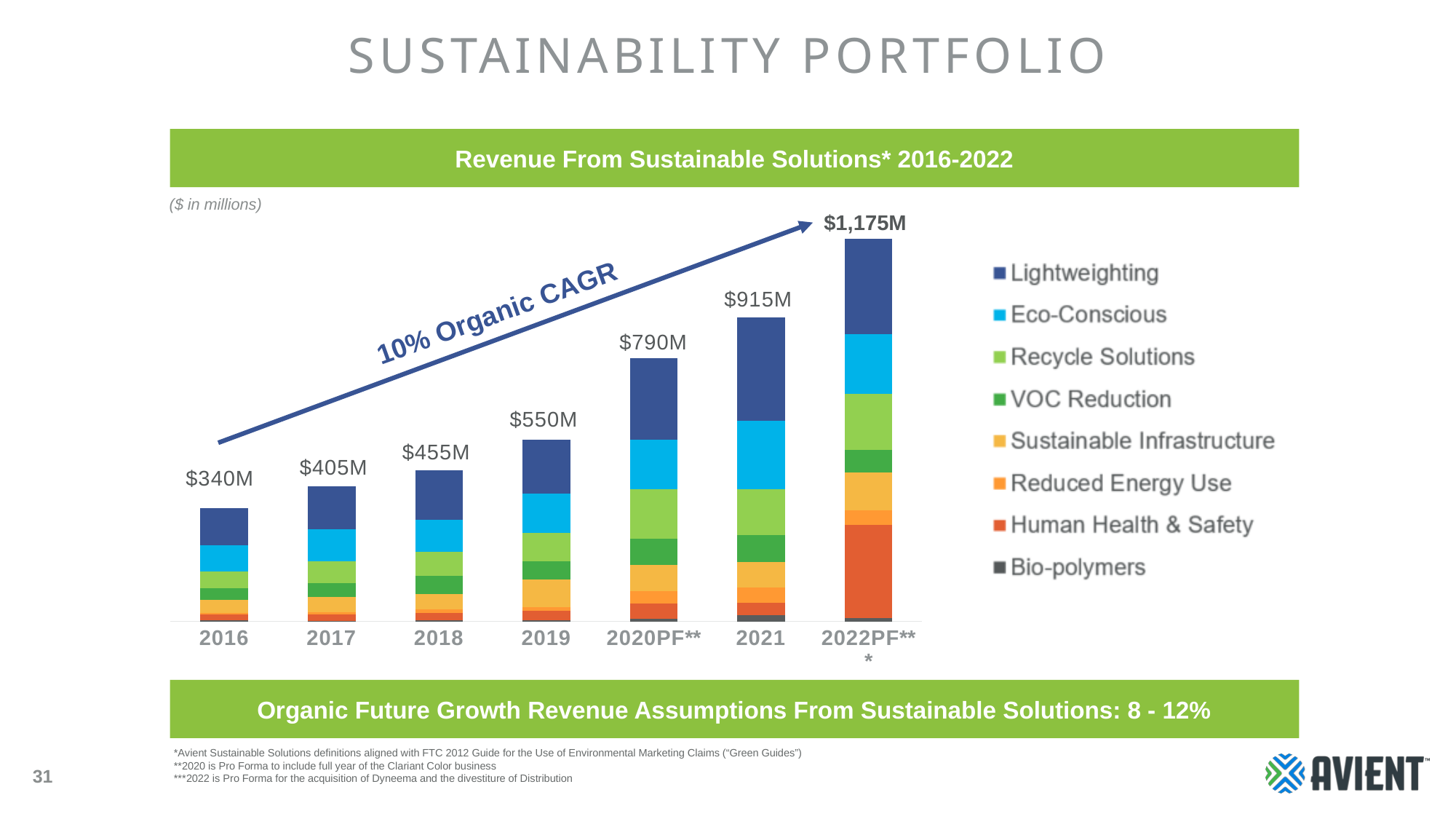
Which year has the highest total revenue from sustainable solutions? 2022PF*** What is the difference between the total revenue for 2018 and for 2017? $50M How many series does the legend list? 8 Which is larger, the total revenue for 2019 or for 2020PF**? 2020PF** What is the total revenue from sustainable solutions shown for 2022PF***? $1,175M Do the total revenue values rise or fall from 2016 to 2022PF***? Rise What is the total revenue from sustainable solutions shown for 2019? $550M What kind of chart is used to show revenue from sustainable solutions? Stacked bar chart Which year has the lowest total revenue from sustainable solutions? 2016 What is the total revenue from sustainable solutions shown for 2016? $340M How many years (bars) are shown on the chart? 7 What is the difference between the total revenue for 2021 and for 2020PF**? $125M